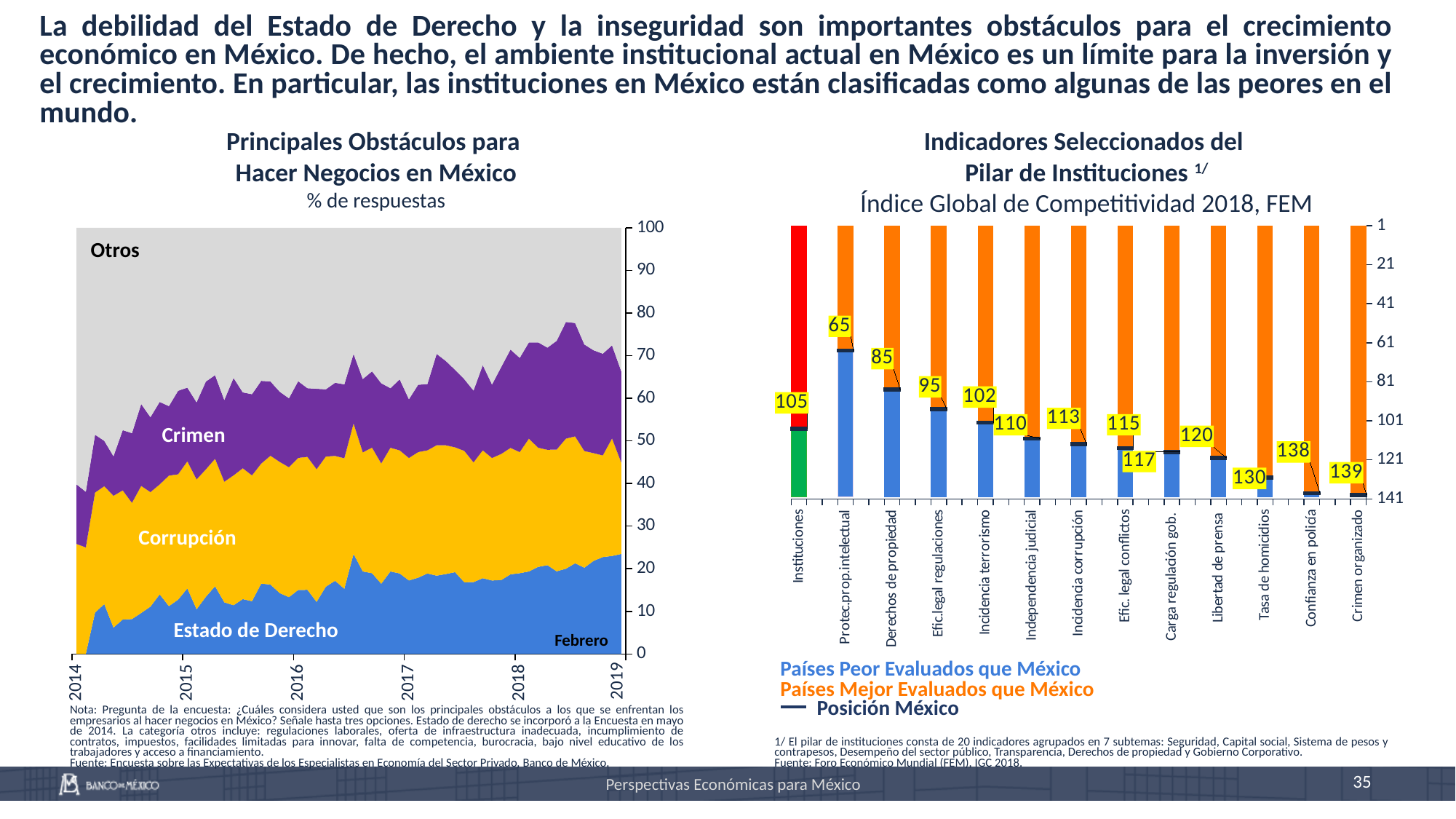
In the right chart, 'Indicadores Seleccionados del Pilar de Instituciones', what is Mexico's position for 'Protec.prop.intelectual'? 65 In the right chart, which indicator has the highest position number for Mexico? Crimen organizado In the right chart, which has the larger position number: 'Independencia judicial' or 'Incidencia corrupción'? Incidencia corrupción In the left chart, does the share for 'Estado de Derecho' rise or fall from 2014 to 2019? Rise In the right chart, which indicator has the lowest position number for Mexico? Protec.prop.intelectual In the right chart, what is the difference between Mexico's position for 'Crimen organizado' and for 'Protec.prop.intelectual'? 74 In the right chart, how many indicators are shown on the x axis? 13 In the right chart, 'Indicadores Seleccionados del Pilar de Instituciones', what is Mexico's position for 'Crimen organizado'? 139 In the left chart, 'Principales Obstáculos para Hacer Negocios en México', how many obstacle categories are shown? 4 In the right chart, 'Indicadores Seleccionados del Pilar de Instituciones', what is Mexico's position for 'Instituciones'? 105 In the right chart, 'Indicadores Seleccionados del Pilar de Instituciones', what is Mexico's position for 'Tasa de homicidios'? 130 What kind of chart is the left chart, 'Principales Obstáculos para Hacer Negocios en México'? Stacked area chart